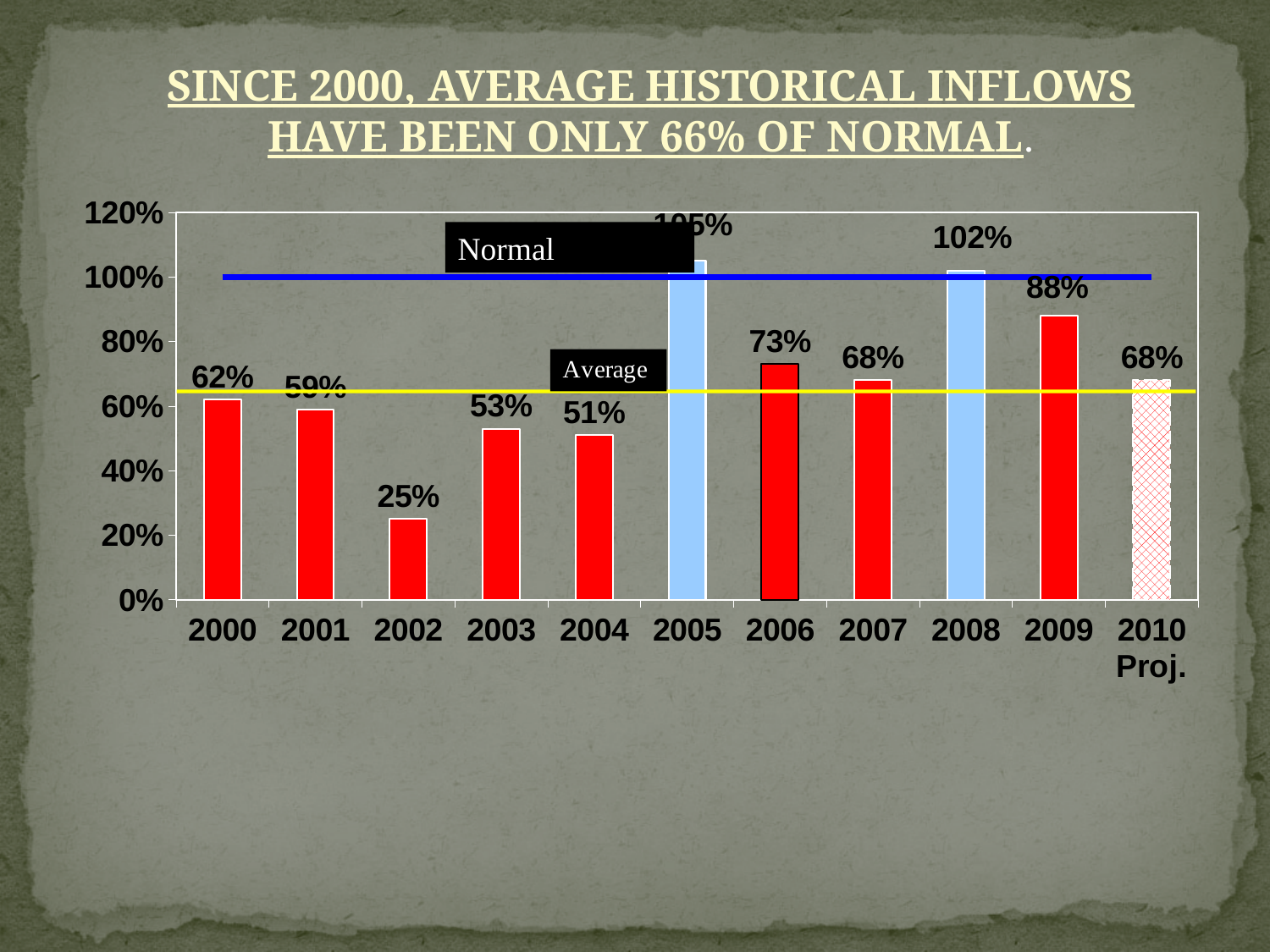
What is the value for 2010 Proj.? 68% Which year has the lowest value? 2002 What is the value for 2008? 102% Do the values rise or fall from 2000 to 2002? fall What is the value for 2004? 51% Which is larger, the value for 2006 or the value for 2007? 2006 What kind of chart is shown on the slide? bar chart Is the value for 2005 greater or less than 100%? greater What is the value for 2002? 25% What does the blue horizontal line on the chart represent? Normal How many years (categories) are shown on the x axis? 11 What is the difference between the values for 2009 and 2007? 20%